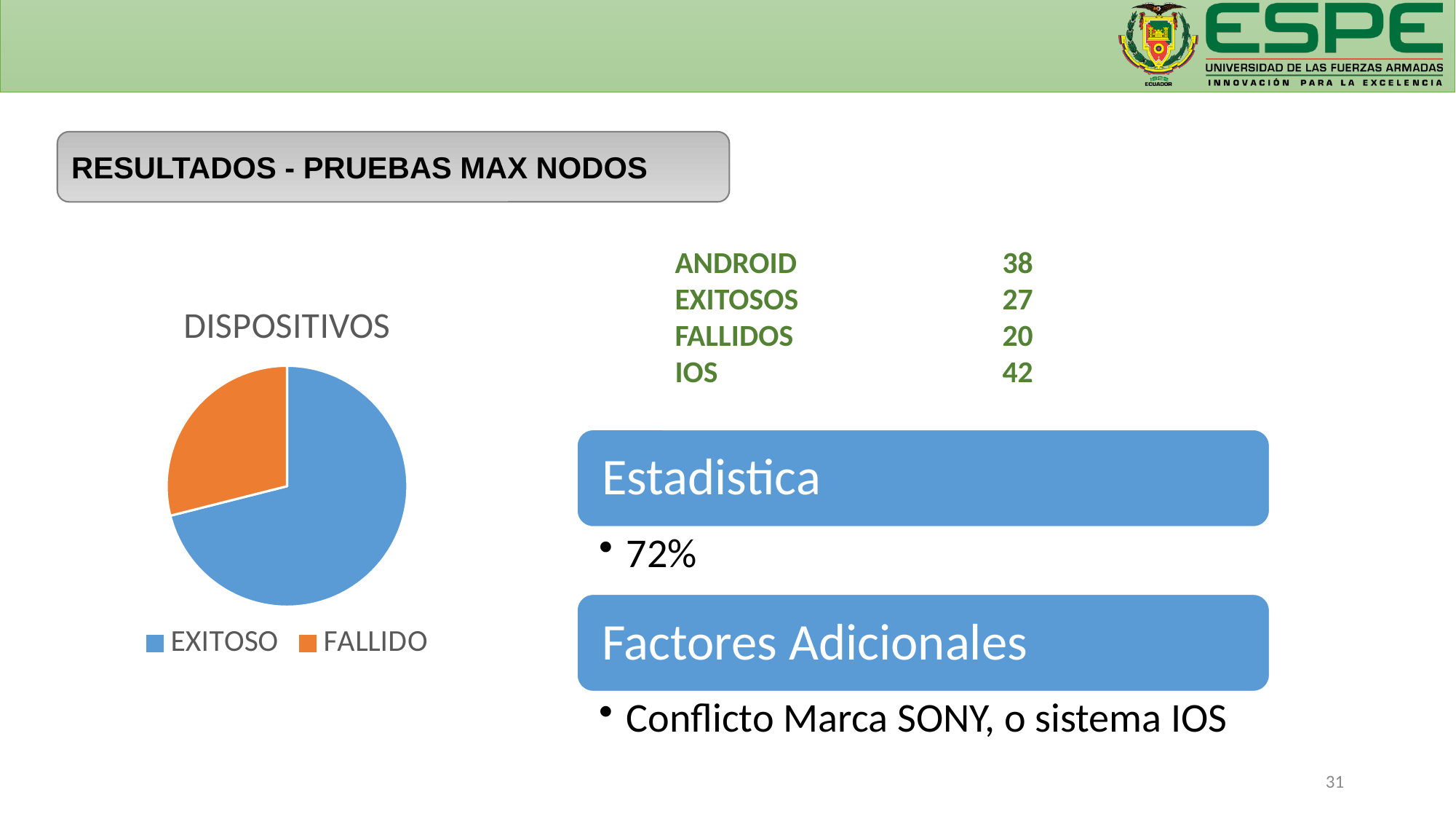
What is the title of the pie chart? DISPOSITIVOS Does the EXITOSO slice take up more or less than half of the pie chart? more What kind of chart is shown on the slide? pie chart Which slice of the pie chart is the largest? EXITOSO Which slice of the pie chart is the smallest? FALLIDO How many slices does the pie chart have? 2 Does the FALLIDO slice take up more or less than half of the pie chart? less Which is larger in the pie chart, EXITOSO or FALLIDO? EXITOSO What colour is the EXITOSO slice in the pie chart? blue How many entries does the legend of the pie chart list? 2